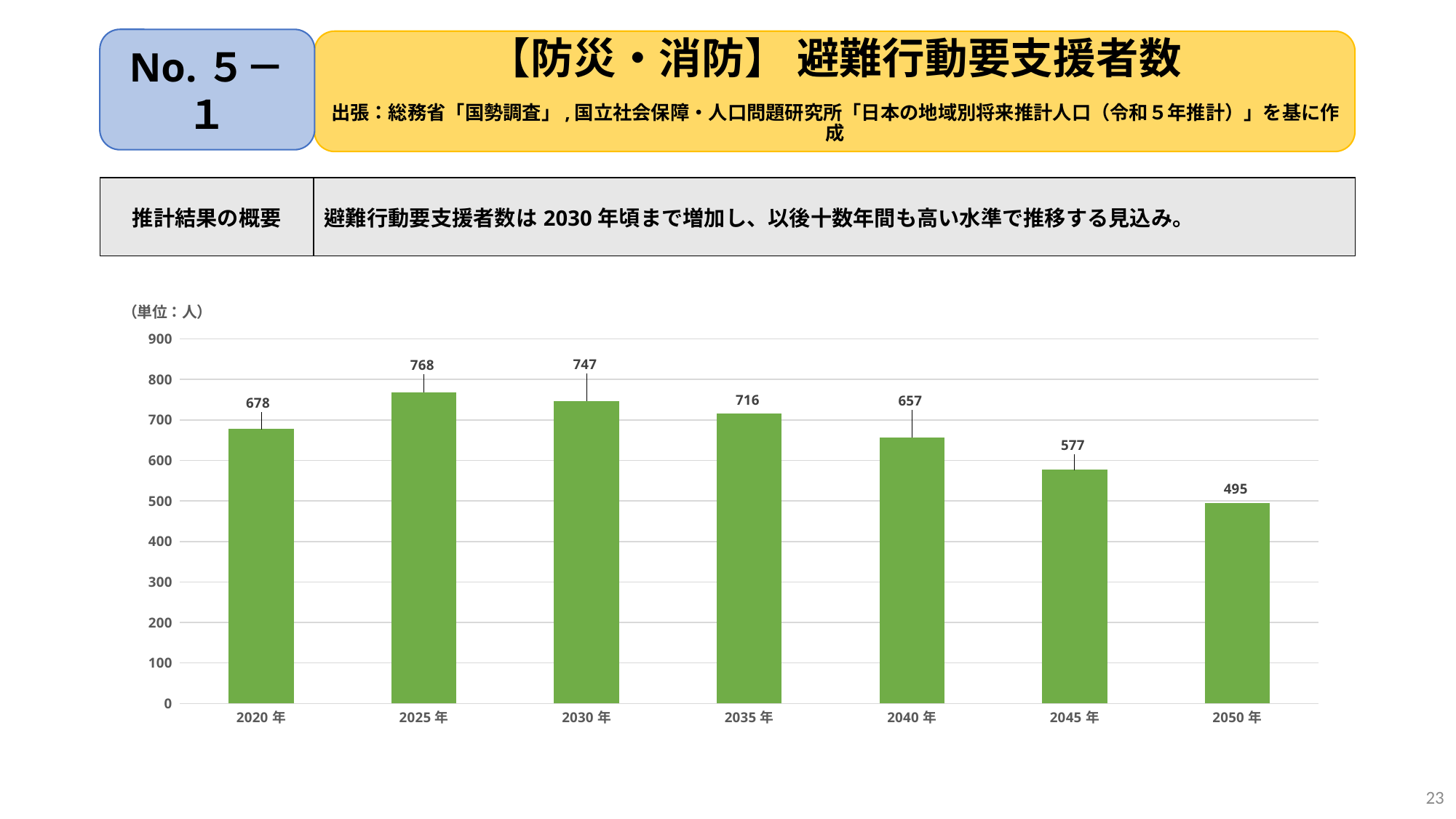
What is the value for 2035年? 716 Which year has the lowest value? 2050年 What kind of chart is shown on the slide? bar chart Is the value for 2045年 greater or less than 600? less What is the value for 2020年? 678 What is the difference between the values for 2030年 and 2035年? 31 How many years are shown on the x axis? 7 What is the difference between the values for 2025年 and 2050年? 273 Which is larger, the value for 2020年 or the value for 2040年? 2020年 Which year has the highest value? 2025年 What is the value for 2050年? 495 What unit is indicated above the chart? 人